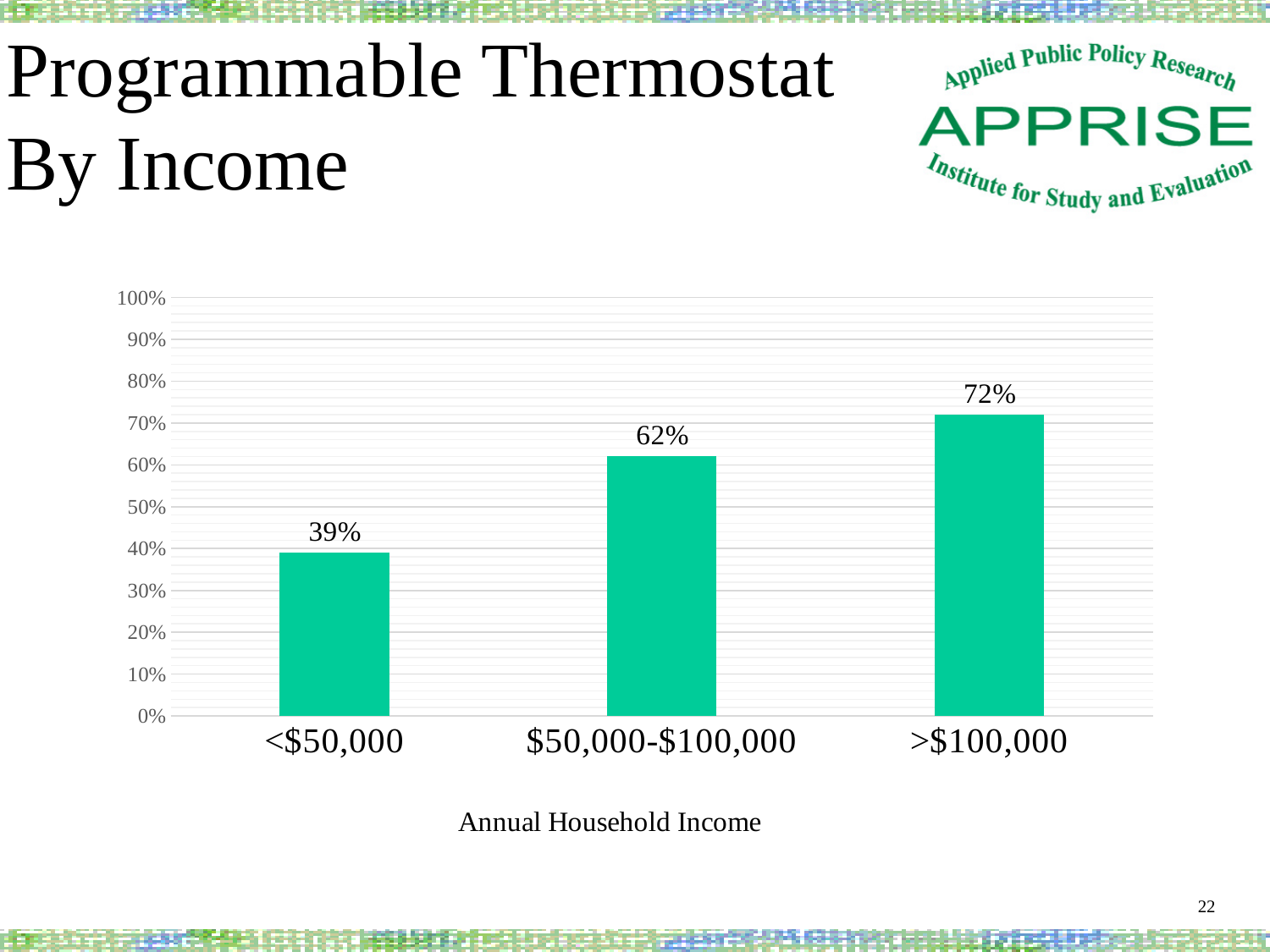
Which income group has the highest value? >$100,000 What is the value for the >$100,000 income group? 72% Do the values rise or fall as income increases along the x axis? rise Which income group has the lowest value? <$50,000 Which is larger, the value for $50,000-$100,000 or the value for >$100,000? >$100,000 What kind of chart is shown on the slide? bar chart What is the difference between the values for >$100,000 and <$50,000? 33% How many income categories are shown on the chart? 3 What is the value for the <$50,000 income group? 39% What is the difference between the values for $50,000-$100,000 and <$50,000? 23% Is the value for <$50,000 greater or less than 50%? less What is the value for the $50,000-$100,000 income group? 62%